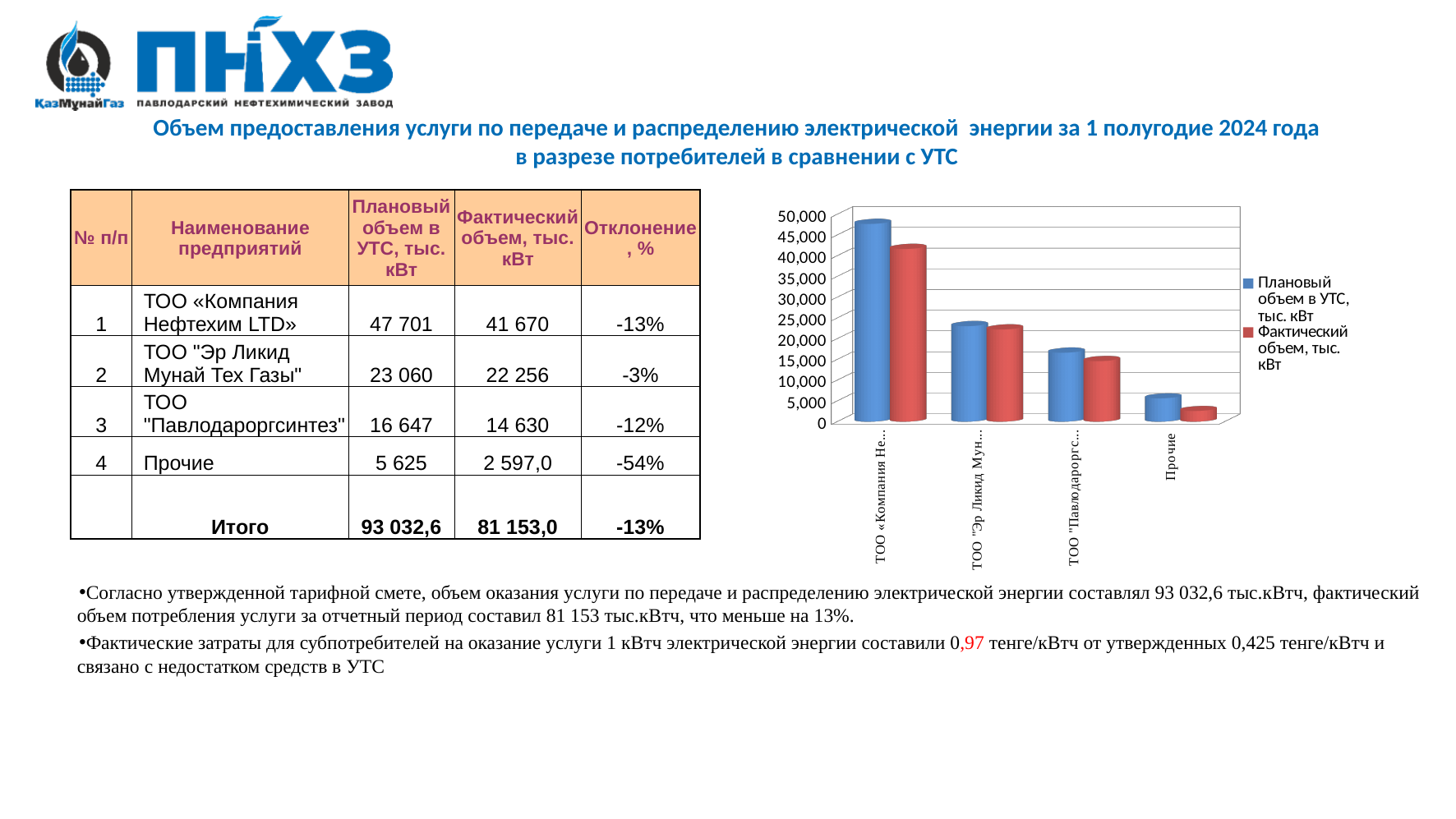
What colour are the bars for the series "Фактический объем, тыс. кВт" in the chart? red What kind of chart is shown on the slide? bar chart Do the planned volumes rise or fall from left to right along the x axis of the chart? fall Is the planned volume for ТОО «Компания Нефтехим LTD» greater or less than 45,000? greater Which category has the highest planned volume (Плановый объем в УТС) in the chart? ТОО «Компания Нефтехим LTD» What is the planned volume in УТС for ТОО "Эр Ликид Мунай Тех Газы", as printed in the table on the slide? 23 060 Is the planned volume for ТОО "Эр Ликид Мунай Тех Газы" greater or less than 20,000? greater How many series does the chart legend list? 2 For ТОО «Компания Нефтехим LTD», which is larger in the chart: the planned volume or the actual volume? planned volume How many consumer categories are plotted on the x axis of the chart? 4 Is the actual volume for Прочие greater or less than 5,000? less Which category has the lowest actual volume (Фактический объем) in the chart? Прочие